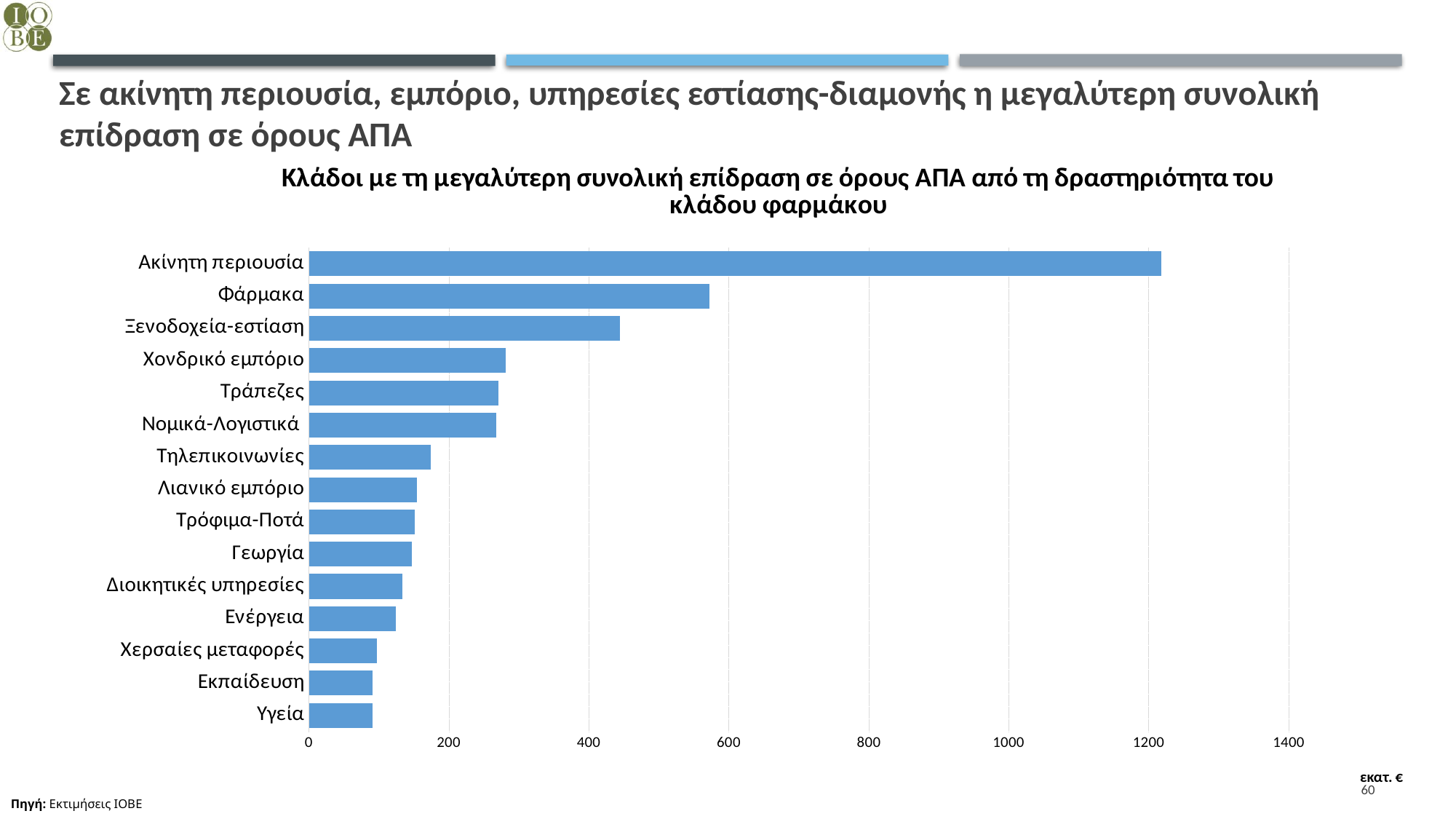
What kind of chart is shown on the slide? bar chart Which sector has the highest value in the chart? Ακίνητη περιουσία How many categories (sectors) are plotted in the chart? 15 Which has a larger value, Φάρμακα or Ξενοδοχεία-εστίαση? Φάρμακα What is the title of the chart? Κλάδοι με τη μεγαλύτερη συνολική επίδραση σε όρους ΑΠΑ από τη δραστηριότητα του κλάδου φαρμάκου Is the value for Υγεία greater or less than 200? less Is the value for Τηλεπικοινωνίες greater or less than 200? less Which has a larger value, Χονδρικό εμπόριο or Ενέργεια? Χονδρικό εμπόριο What unit is indicated for the values in the chart? εκατ. € Is the value for Ακίνητη περιουσία greater or less than 1200? greater